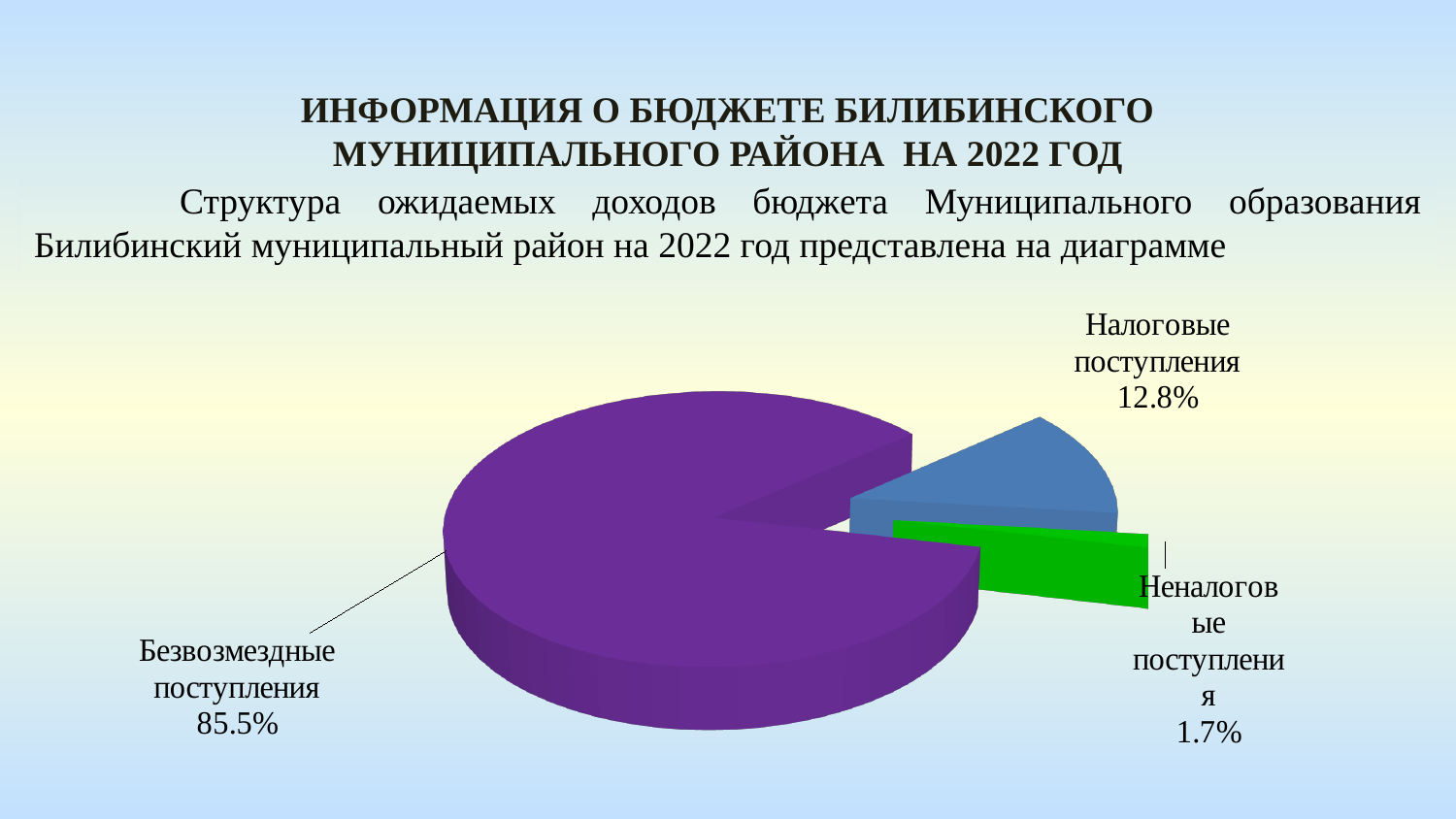
What share of the pie is labelled "Налоговые поступления"? 12.8% What share of the pie is labelled "Неналоговые поступления"? 1.7% How many slices does the pie chart have? 3 Which category has the largest share of the pie? Безвозмездные поступления What colour is the slice for "Безвозмездные поступления"? Purple What colour is the slice for "Неналоговые поступления"? Green What is the difference in percentage points between "Безвозмездные поступления" and "Налоговые поступления"? 72.7 What share of the pie is labelled "Безвозмездные поступления"? 85.5% Which category has the smallest share of the pie? Неналоговые поступления What is the difference in percentage points between "Налоговые поступления" and "Неналоговые поступления"? 11.1 What kind of chart is shown on the slide? Pie chart Which is larger: the share for "Налоговые поступления" or the share for "Неналоговые поступления"? Налоговые поступления